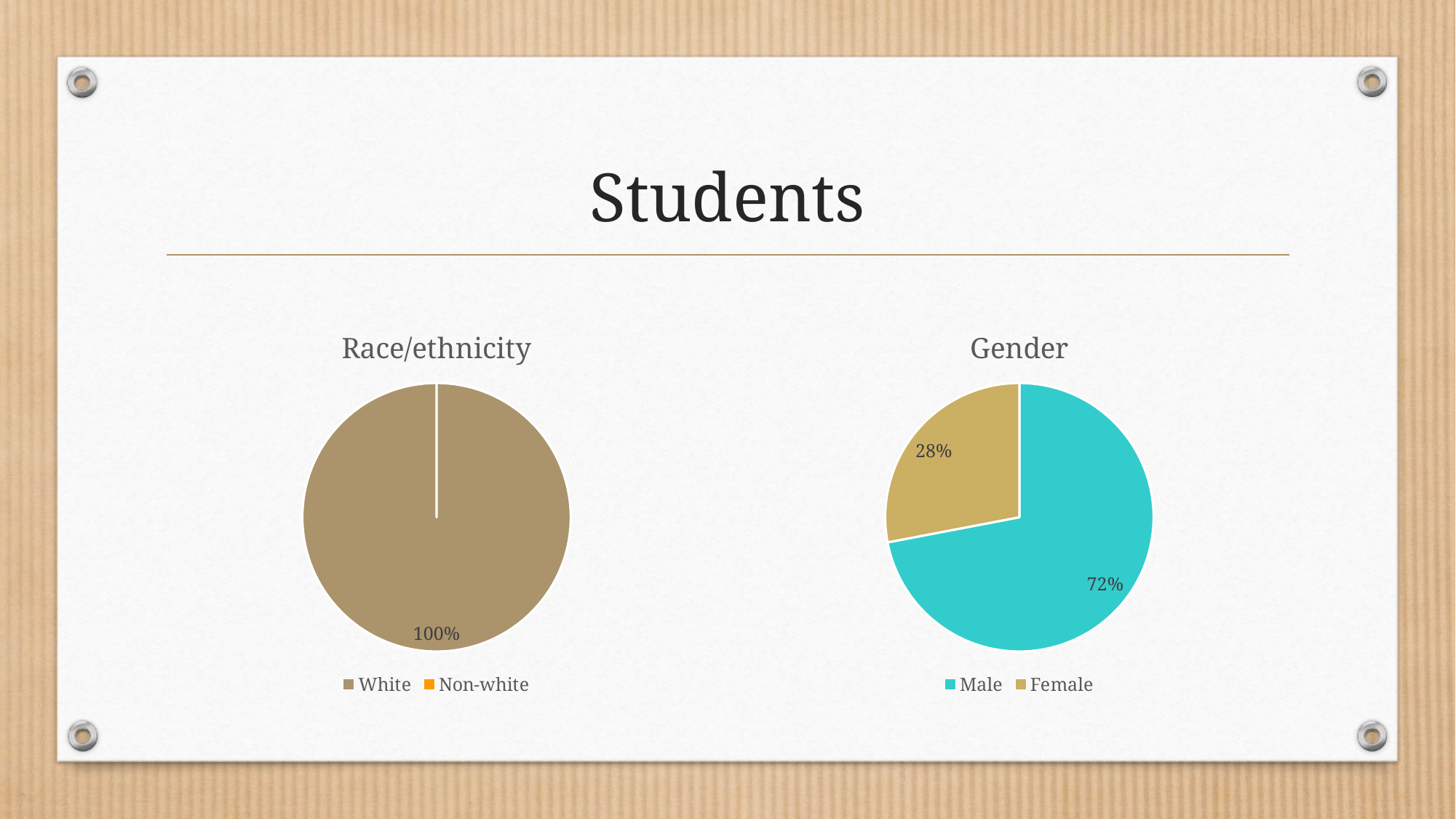
What kind of chart is the Gender chart? Pie chart In the Gender chart, what is the difference between the Male and Female shares? 44% What kind of chart is the Race/ethnicity chart? Pie chart In the Gender chart, what share of students is Male? 72% In the Gender chart, which is larger, the Male share or the Female share? Male In the Gender chart, which category has the smallest share? Female How many categories does the legend of the Race/ethnicity chart list? 2 In the Gender chart, which category has the largest share? Male In the Gender chart, what share of students is Female? 28% What is the title of the chart on the left of the slide? Race/ethnicity How many categories does the legend of the Gender chart list? 2 In the Race/ethnicity chart, what share of students is White? 100%